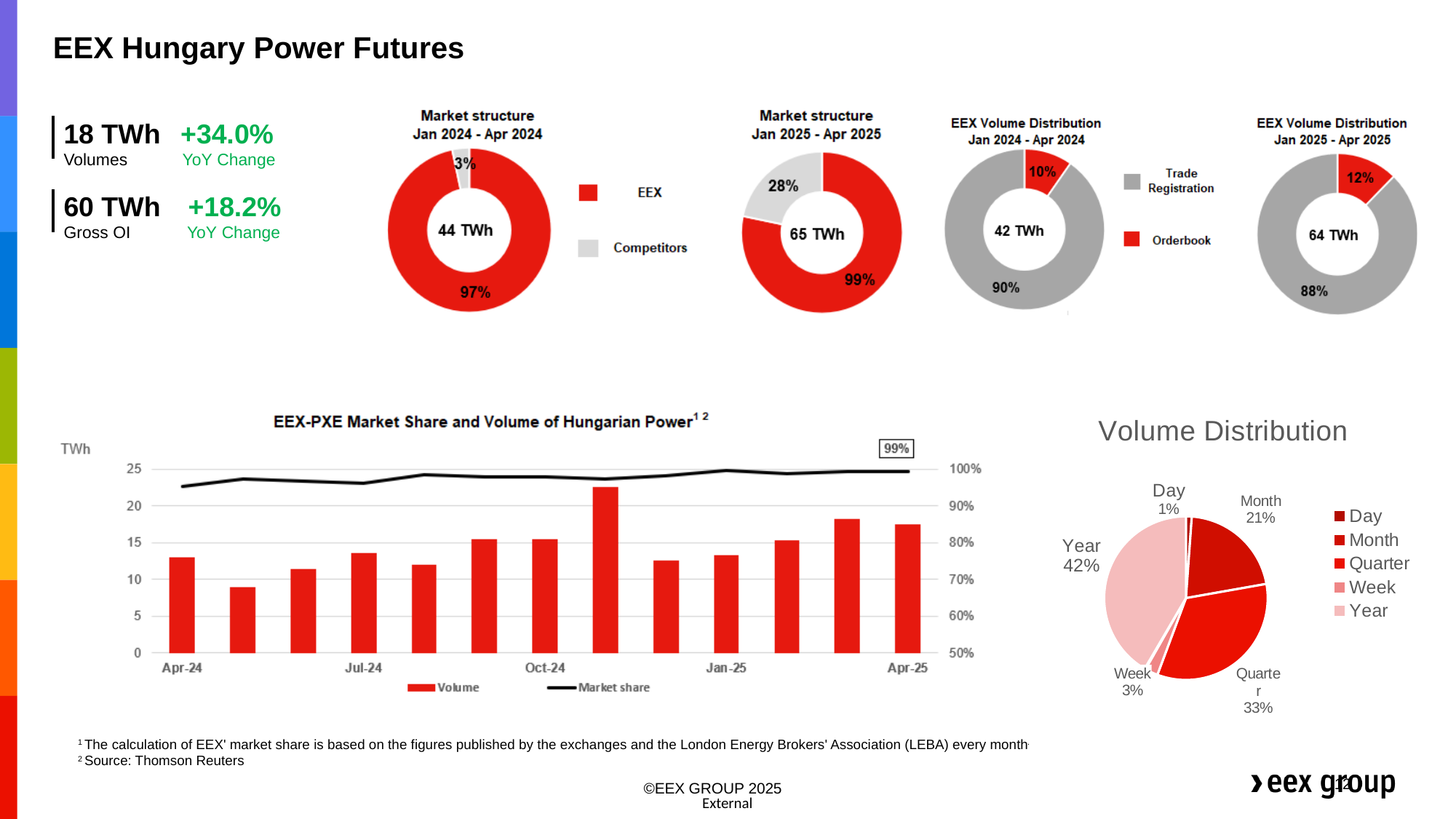
In the Volume Distribution pie chart, what share does Year have? 42% In the EEX Volume Distribution Jan 2024 - Apr 2024 donut chart, which is larger, Trade Registration or Orderbook? Trade Registration How many entries does the legend of the Volume Distribution pie chart list? 5 What total volume is shown in the centre of the Market structure Jan 2025 - Apr 2025 donut chart? 65 TWh In the Market structure Jan 2024 - Apr 2024 donut chart, what share do Competitors have? 3% What market share value is labelled at the end of the line in the EEX-PXE Market Share and Volume of Hungarian Power chart? 99% In the Volume Distribution pie chart, which category has the largest share? Year In the Volume Distribution pie chart, which category has the smallest share? Day In the Volume Distribution pie chart, what is the difference between the Quarter share and the Month share? 12% In the EEX Volume Distribution Jan 2025 - Apr 2025 donut chart, what share does Orderbook have? 12% In the EEX-PXE Market Share and Volume of Hungarian Power chart, is the volume bar for Apr-25 greater or less than 15 TWh? greater How many bars are plotted in the EEX-PXE Market Share and Volume of Hungarian Power chart? 13